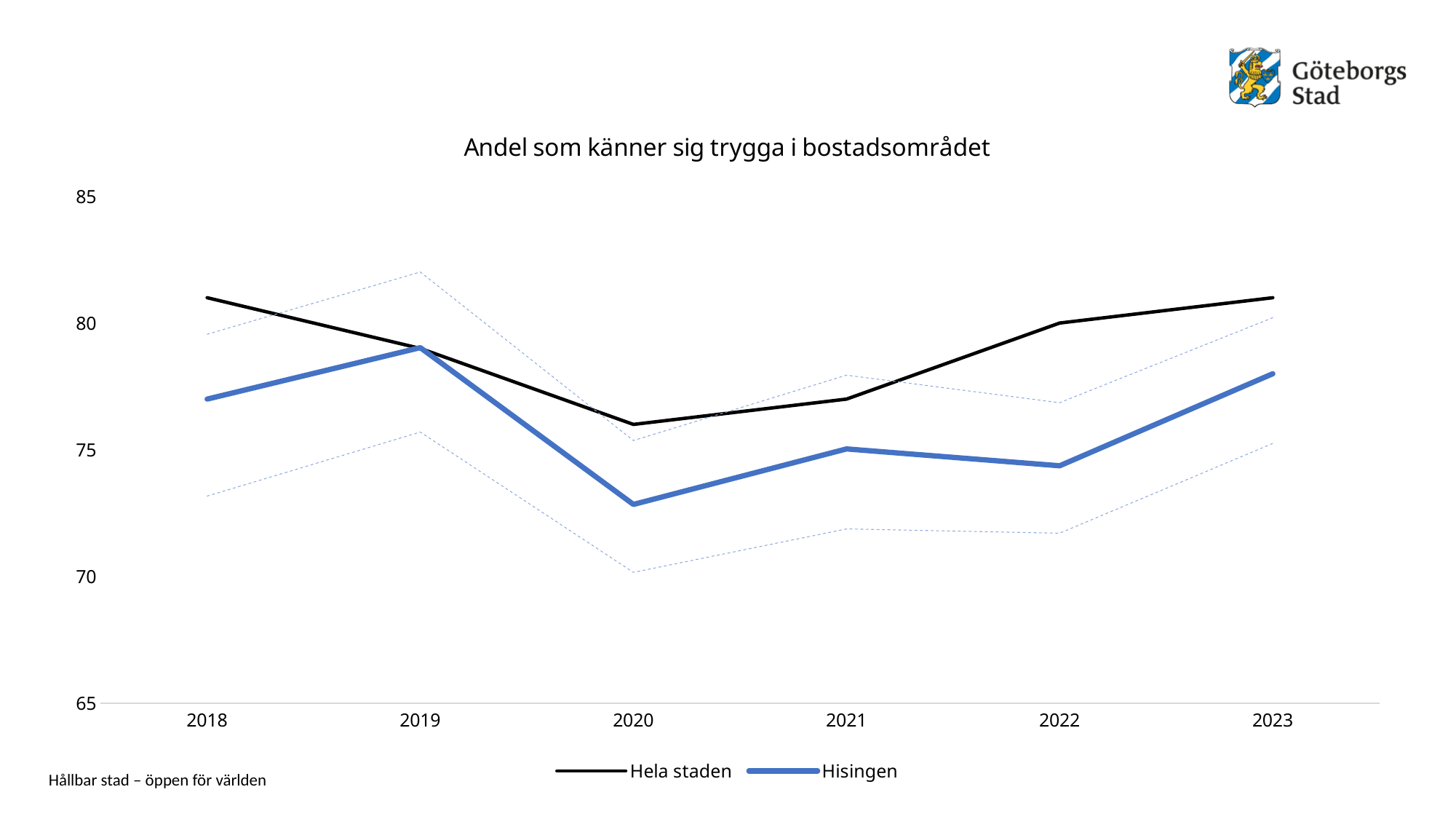
What kind of chart is shown on the slide? Line chart How many years are shown on the x axis? 6 In 2018, which series has the higher value, Hela staden or Hisingen? Hela staden Is the value for Hela staden in 2020 greater or less than 75? greater How many series does the legend list? 2 What is the title of the chart? Andel som känner sig trygga i bostadsområdet Which series is drawn with the blue line? Hisingen Is the value for Hisingen in 2023 greater or less than 80? less Is the value for Hela staden in 2018 greater or less than 80? greater In which year is the value for Hisingen lowest? 2020 In which year is the value for Hela staden lowest? 2020